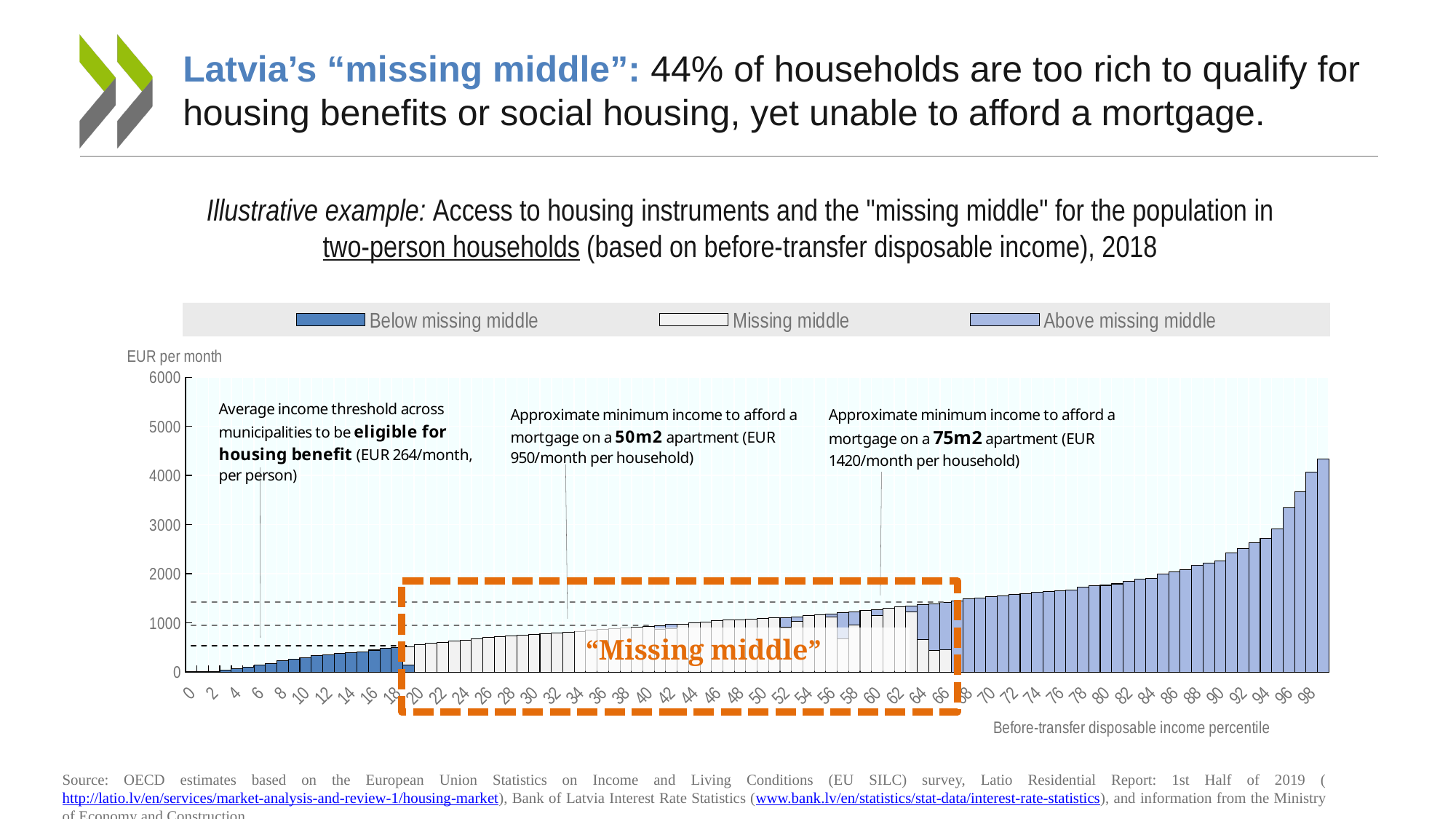
Is the value for the 90th percentile greater or less than 2000? greater According to the chart annotation, what is the approximate minimum income to afford a mortgage on a 50m2 apartment? EUR 950/month per household Do the bar values rise or fall as the income percentile increases along the x axis? rise Is the value for the 20th percentile greater or less than 1000? less Is the value for the 70th percentile greater or less than 1000? greater What is the label on the chart's x axis? Before-transfer disposable income percentile What kind of chart is shown on the slide? bar chart What are the three series named in the chart legend? Below missing middle, Missing middle, Above missing middle According to the chart annotation, what is the approximate minimum income to afford a mortgage on a 75m2 apartment? EUR 1420/month per household How many series does the chart legend list? 3